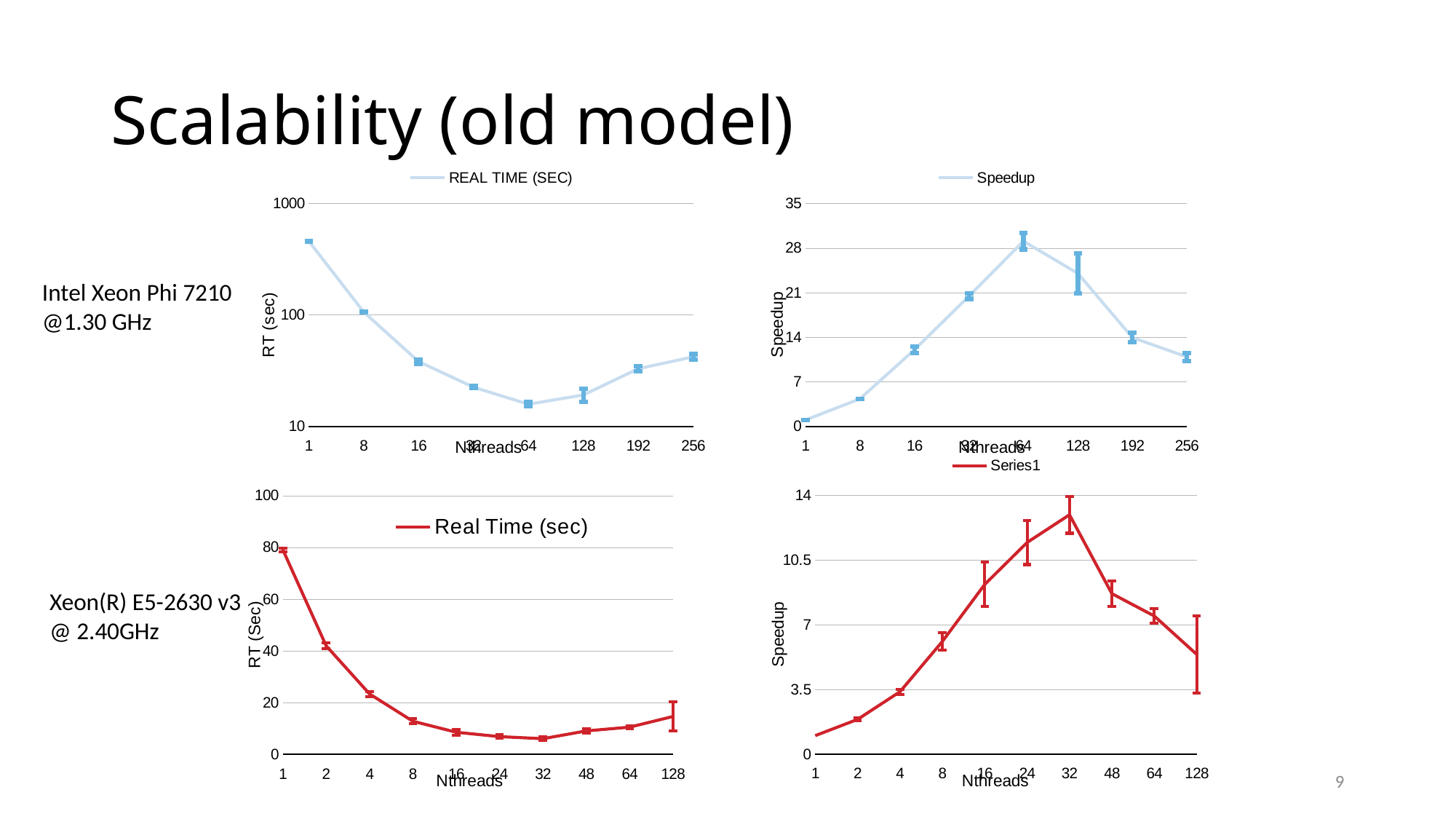
In the bottom-left chart (Real Time (sec)), is the real time at 1 thread greater or less than 60? greater In the top-right chart (Speedup), at which Nthreads value is the speedup highest? 64 In the bottom-left chart (Real Time (sec)), does the real time rise or fall from 1 thread to 32 threads? fall In the top-right chart (Speedup), which has the larger speedup: 32 threads or 192 threads? 32 threads In the top-right chart (Speedup), is the speedup at 256 threads greater or less than 14? less In the top-left chart (REAL TIME (SEC)), is the real time at 1 thread greater or less than 100? greater In the bottom-right chart (Series1), at which Nthreads value is the speedup highest? 32 What kind of chart is the top-left chart titled REAL TIME (SEC)? line chart In the bottom-left chart (Real Time (sec)), how many Nthreads values are plotted along the x axis? 10 What is the legend entry shown for the bottom-right chart? Series1 In the top-left chart (REAL TIME (SEC)), how many Nthreads values are plotted along the x axis? 8 In the top-left chart (REAL TIME (SEC)), at which Nthreads value is the real time highest? 1